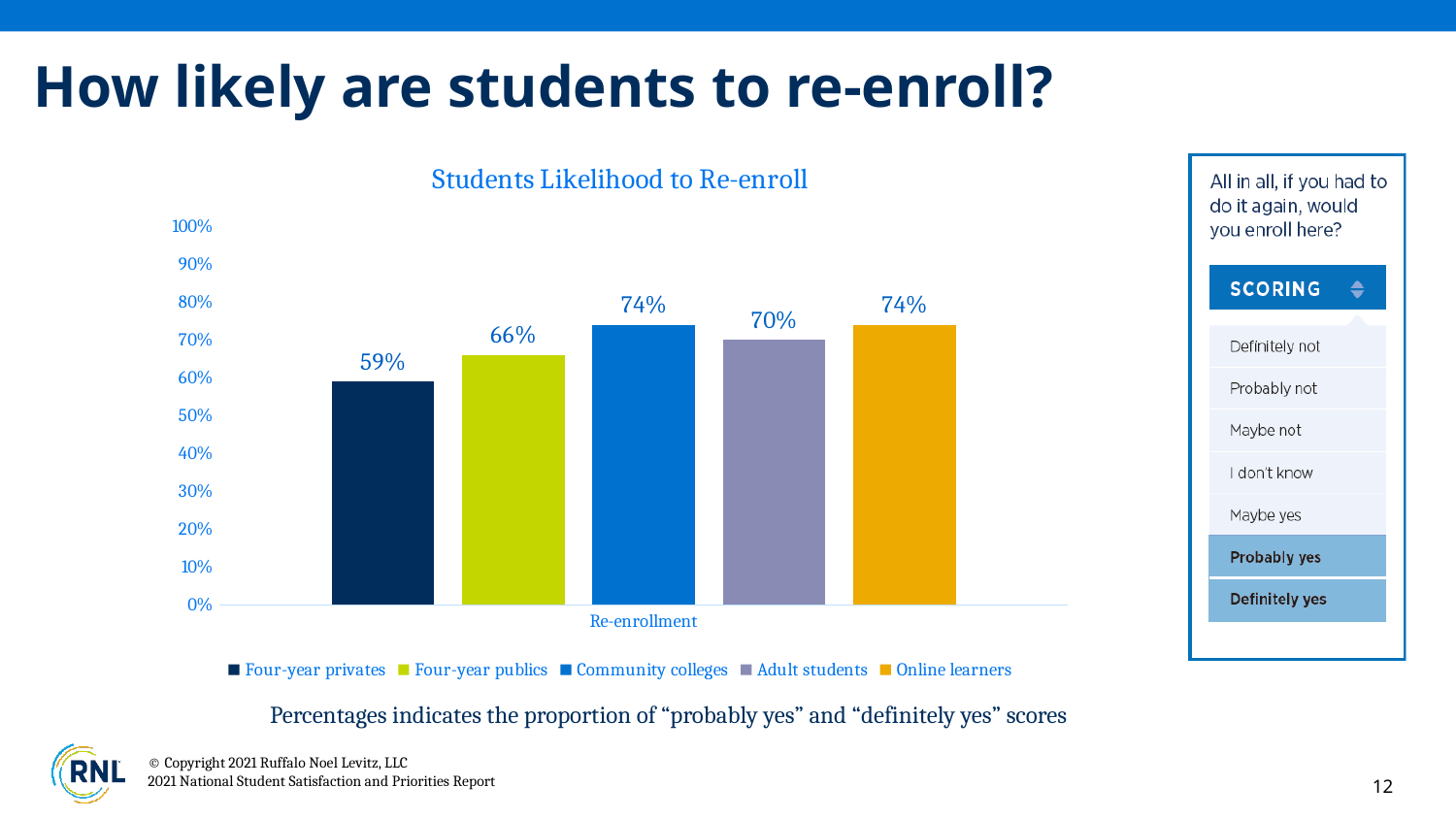
Is the value for Four-year privates greater or less than 60%? less What is the value for Four-year publics? 66% What is the difference between the values for Community colleges and Four-year privates? 15% Which series has the lowest likelihood to re-enroll? Four-year privates Which is larger, the value for Four-year publics or the value for Adult students? Adult students What is the value for Four-year privates in the Students Likelihood to Re-enroll chart? 59% What is the value for Adult students? 70% What is the value for Community colleges? 74% How many series does the legend list? 5 What is the difference between the values for Adult students and Four-year publics? 4% What kind of chart is shown on the slide? Bar chart What is the title of the chart? Students Likelihood to Re-enroll